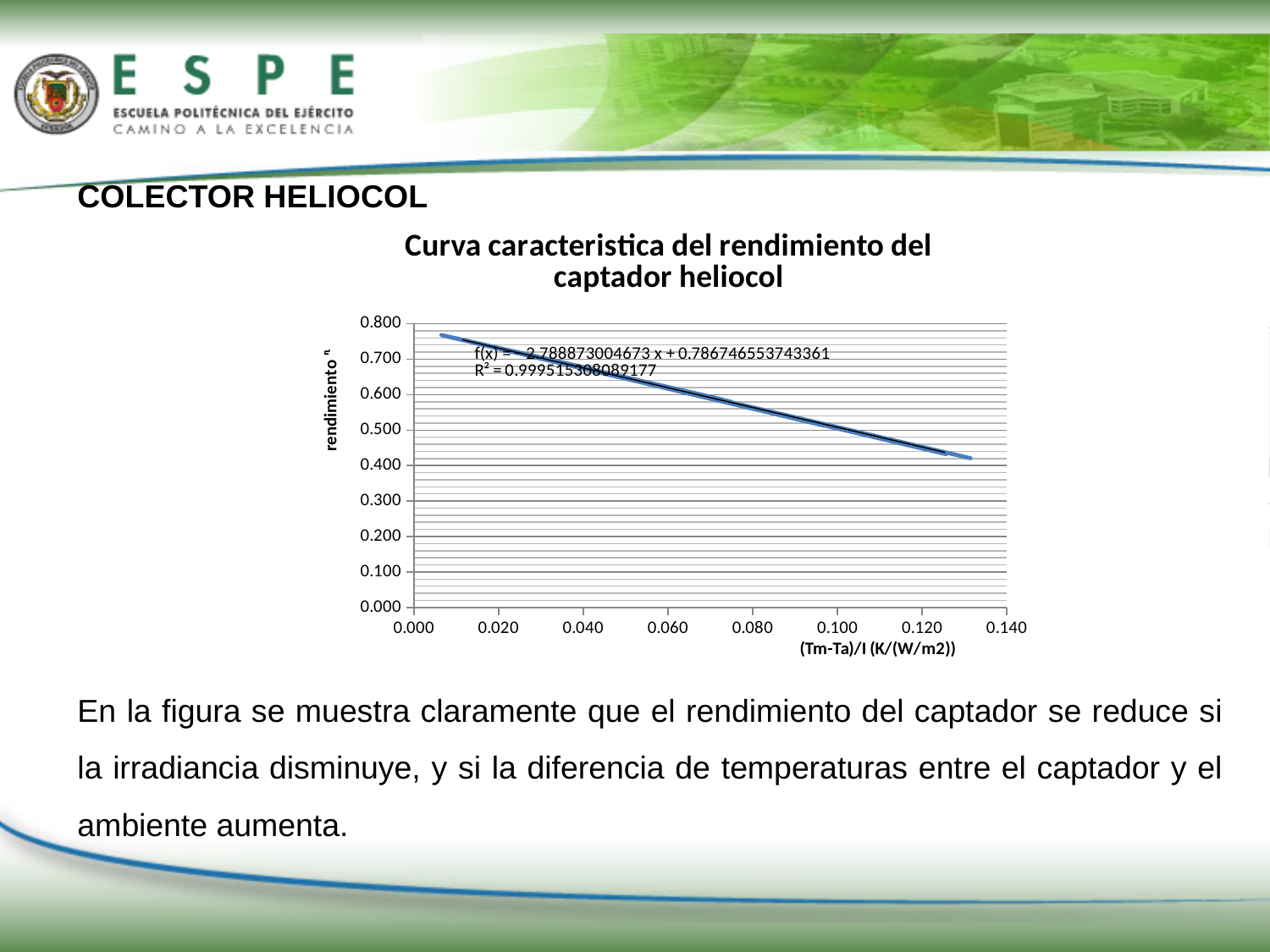
What is the maximum value shown on the x axis? 0.140 What R² value is shown for the trendline? 0.999515308089177 What is the title of the chart? Curva caracteristica del rendimiento del captador heliocol Is the rendimiento value at (Tm-Ta)/I = 0.120 greater or less than 0.500? less Do the plotted values rise or fall as (Tm-Ta)/I increases along the x axis? fall What is the maximum value shown on the y axis? 0.800 What is the intercept of the trendline equation shown on the chart? 0.786746553743361 What is the label of the x axis? (Tm-Ta)/I (K/(W/m2)) Is the rendimiento value at (Tm-Ta)/I = 0.080 greater or less than 0.600? less What kind of chart is shown on the slide? scatter chart with a linear trendline Is the rendimiento value at (Tm-Ta)/I = 0.020 greater or less than 0.700? greater What is the slope of the trendline equation shown on the chart? -2.788873004673